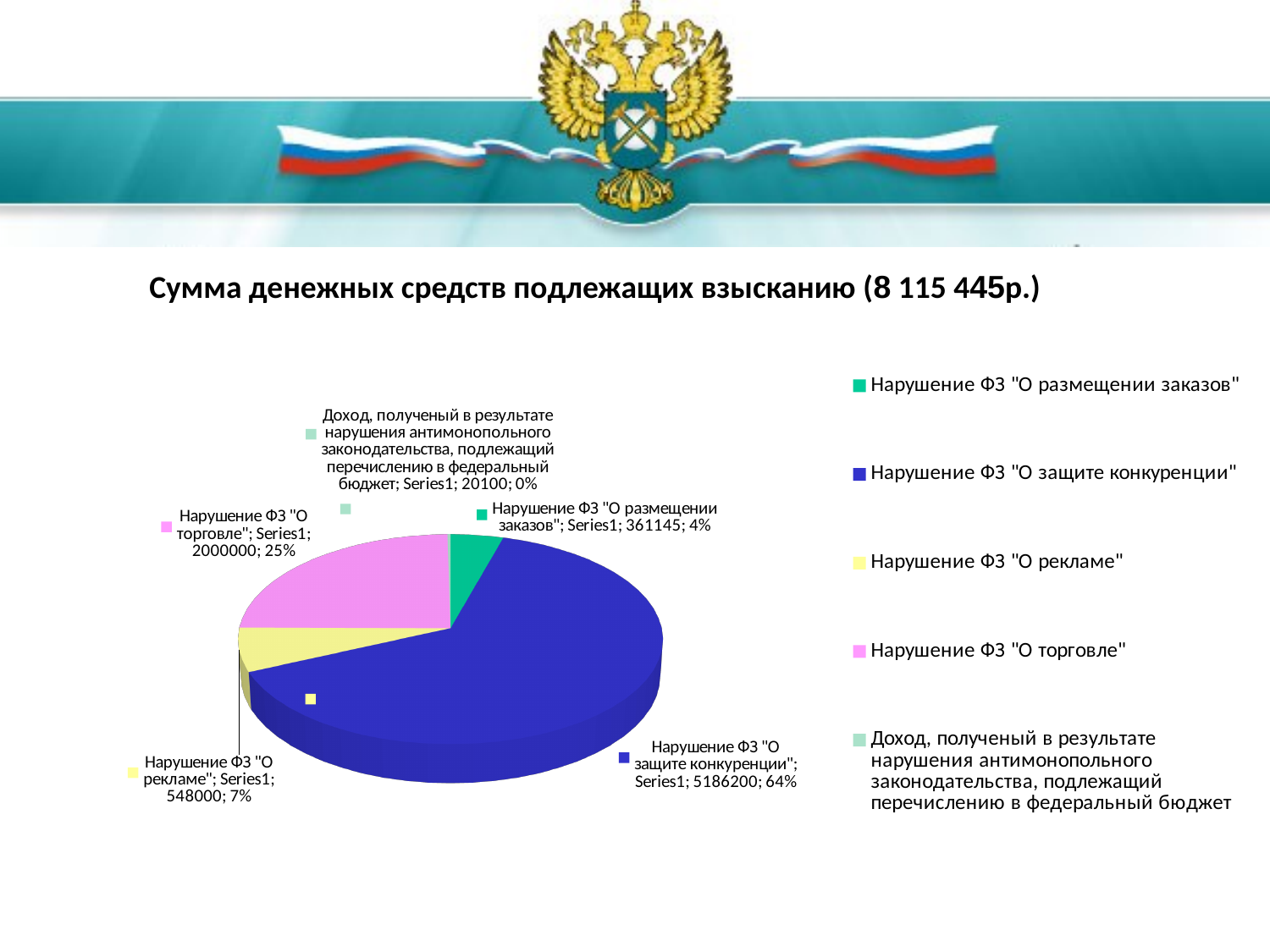
What is the value for Нарушение ФЗ "О размещении заказов"? 361145 What is the difference between the values for Нарушение ФЗ "О торговле" and Нарушение ФЗ "О рекламе"? 1452000 What percentage share does Нарушение ФЗ "О защите конкуренции" have in the pie? 64% Which is larger, the value for Нарушение ФЗ "О рекламе" or the value for Нарушение ФЗ "О размещении заказов"? Нарушение ФЗ "О рекламе" What kind of chart is shown on the slide? pie chart Which category has the largest slice of the pie? Нарушение ФЗ "О защите конкуренции" What percentage share does Нарушение ФЗ "О торговле" have in the pie? 25% What is the value for Нарушение ФЗ "О торговле"? 2000000 What is the value for Нарушение ФЗ "О защите конкуренции"? 5186200 Which category has the smallest slice of the pie? Доход, полученый в результате нарушения антимонопольного законодательства, подлежащий перечислению в федеральный бюджет What is the value for Нарушение ФЗ "О рекламе"? 548000 How many categories does the legend list? 5